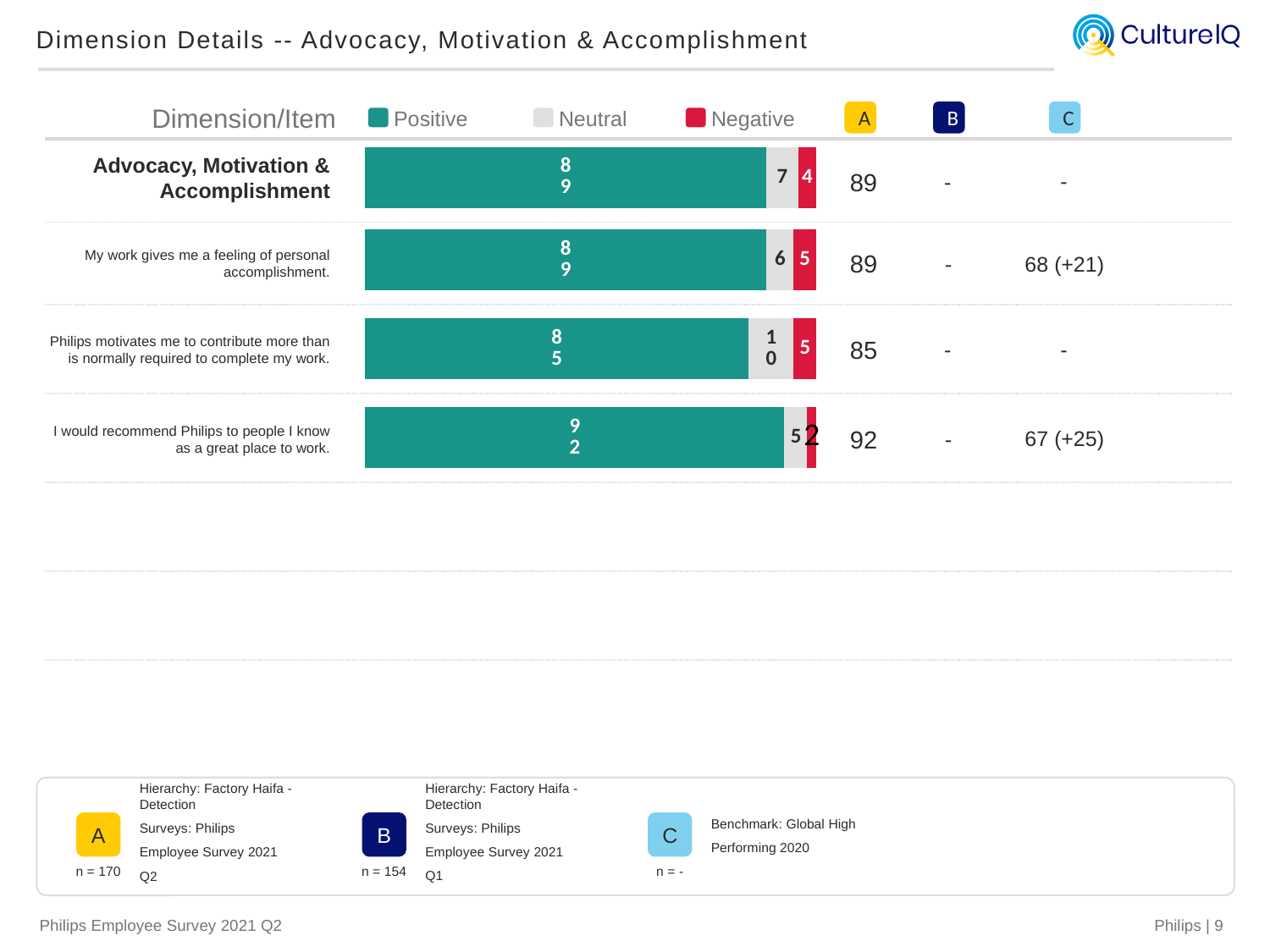
What is the Negative value for "My work gives me a feeling of personal accomplishment"? 5 What is the Neutral value for "Philips motivates me to contribute more than is normally required to complete my work"? 10 What is the difference between the Positive values for "I would recommend Philips to people I know as a great place to work" and "Philips motivates me to contribute more than is normally required to complete my work"? 7 What is the Positive value for "I would recommend Philips to people I know as a great place to work"? 92 Which item has the lowest Positive value? Philips motivates me to contribute more than is normally required to complete my work. Which item has the highest Positive value? I would recommend Philips to people I know as a great place to work. How many rows (dimension/items) are plotted in the chart? 4 What is the value shown in column C for "My work gives me a feeling of personal accomplishment"? 68 (+21) What is the Positive value for the "Advocacy, Motivation & Accomplishment" dimension row? 89 Which is larger: the Neutral value for "Philips motivates me to contribute more than is normally required to complete my work" or the Neutral value for "I would recommend Philips to people I know as a great place to work"? Philips motivates me to contribute more than is normally required to complete my work. How many series does the legend list? 3 What kind of chart is shown on the slide? Stacked bar chart